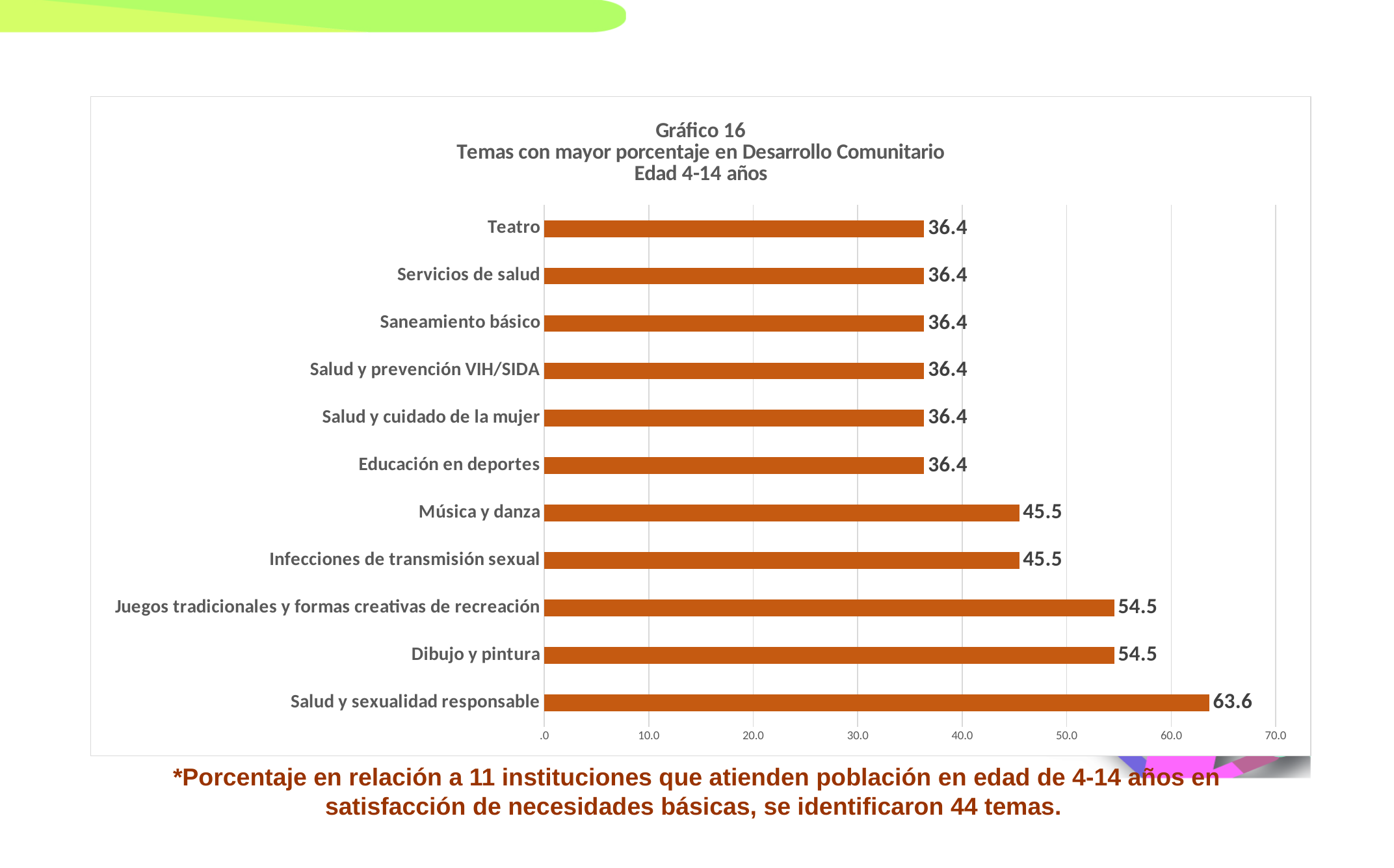
Which is larger, Dibujo y pintura or Servicios de salud? Dibujo y pintura What is the value for Música y danza? 45.5 How many categories are shown in the chart? 11 What is the value for Teatro? 36.4 What is the value for Dibujo y pintura? 54.5 What is the value for Salud y sexualidad responsable? 63.6 What is the difference between Infecciones de transmisión sexual and Educación en deportes? 9.1 What is the difference between Salud y sexualidad responsable and Juegos tradicionales y formas creativas de recreación? 9.1 What kind of chart is shown on the slide? bar chart Which category has the highest value? Salud y sexualidad responsable What is the title of the chart? Gráfico 16 Temas con mayor porcentaje en Desarrollo Comunitario Edad 4-14 años Is the value for Saneamiento básico greater or less than 40.0? less